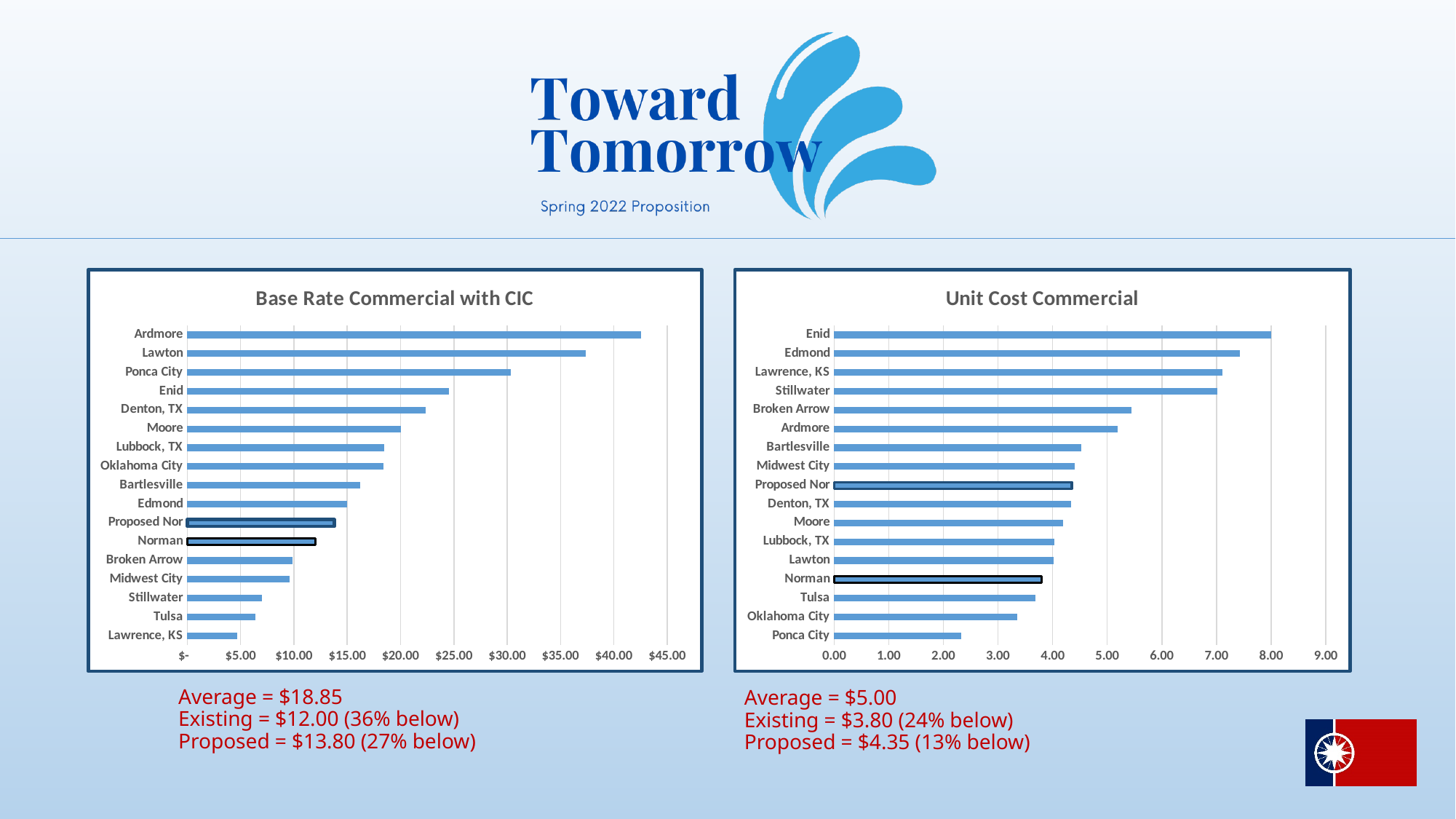
In the 'Base Rate Commercial with CIC' chart, which is larger, the value for Lawton or the value for Enid? Lawton In the 'Base Rate Commercial with CIC' chart, is the value for Stillwater greater or less than $10.00? less In the 'Unit Cost Commercial' chart, which city has the highest unit cost? Enid What type of chart is 'Unit Cost Commercial'? bar chart In the 'Base Rate Commercial with CIC' chart, which city has the lowest base rate? Lawrence, KS In the 'Unit Cost Commercial' chart, is the value for Broken Arrow greater or less than 5.00? greater In the 'Unit Cost Commercial' chart, which is larger, the value for Edmond or the value for Stillwater? Edmond In the 'Base Rate Commercial with CIC' chart, is the value for Ardmore greater or less than $40.00? greater In the 'Base Rate Commercial with CIC' chart, which city has the highest base rate? Ardmore In the 'Unit Cost Commercial' chart, which city has the lowest unit cost? Ponca City How many cities are listed in the 'Base Rate Commercial with CIC' chart? 17